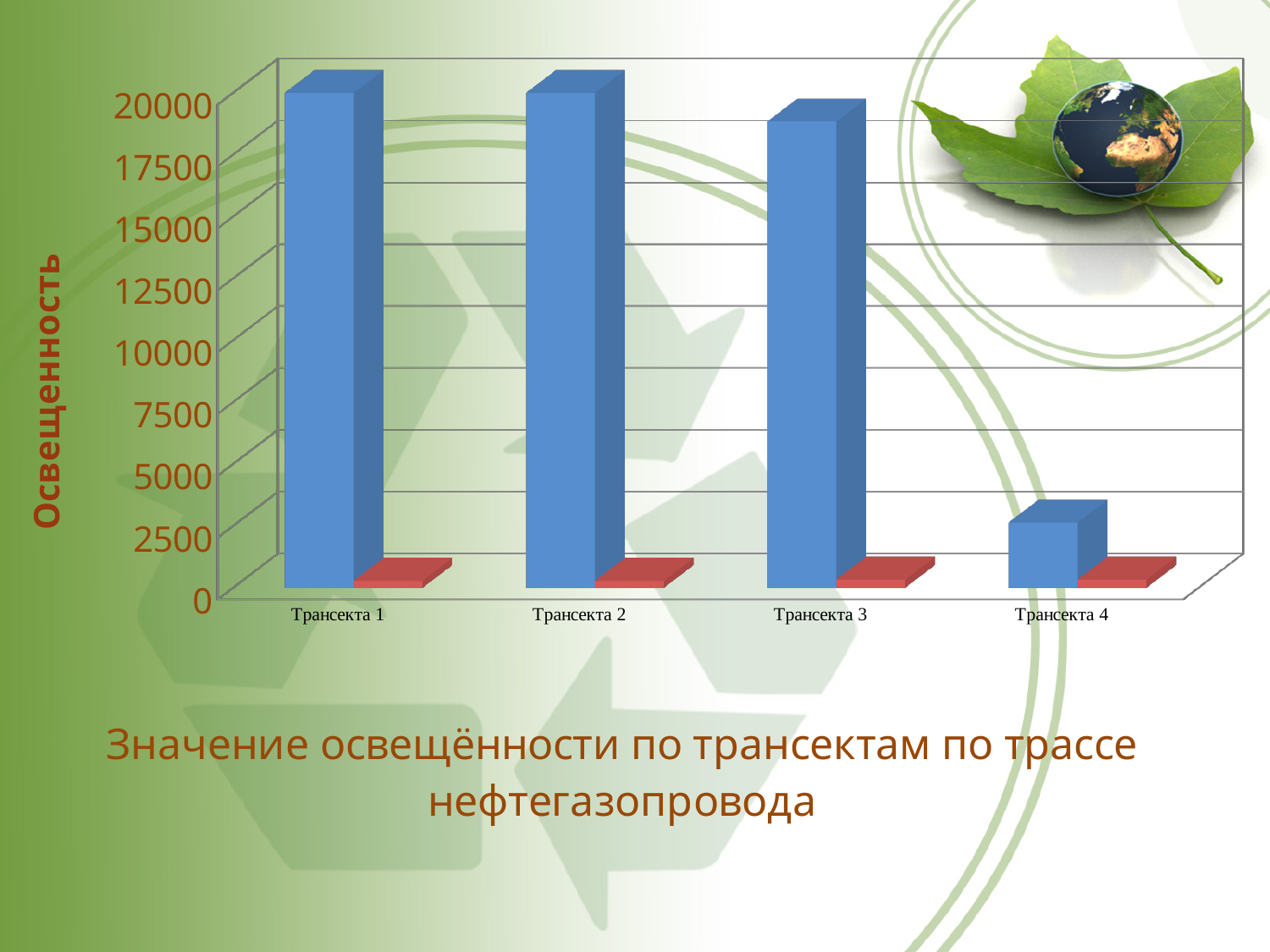
Which transect has the lowest blue bar in the chart? Трансекта 4 Which has the larger blue bar, Трансекта 3 or Трансекта 4? Трансекта 3 Is the blue bar value for Трансекта 4 greater or less than 5000? less Do the blue bar values rise or fall from Трансекта 1 to Трансекта 4? fall Is the blue bar value for Трансекта 2 greater or less than 17500? greater How many transect categories are shown on the x axis of the chart? 4 Is the blue bar value for Трансекта 1 greater or less than 10000? greater What kind of chart is shown on the slide? bar chart What is the label on the vertical axis of the chart? Освещенность What is the highest tick value shown on the vertical axis of the chart? 20000